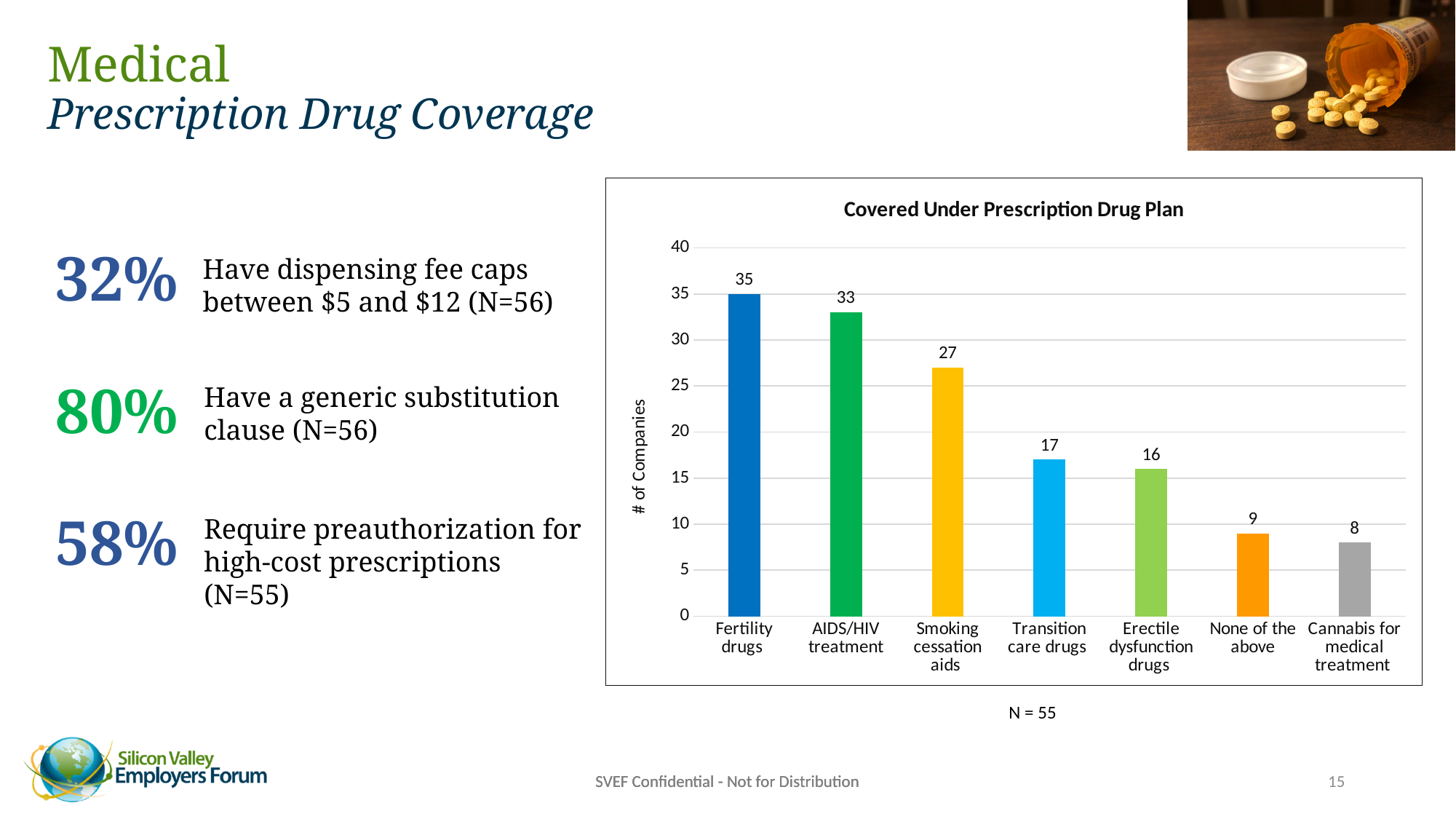
What is the difference between the number of companies covering fertility drugs and those covering AIDS/HIV treatment? 2 How many companies cover fertility drugs under their prescription drug plan? 35 Which category has the lowest number of companies? Cannabis for medical treatment Which category has the highest number of companies? Fertility drugs How many companies cover cannabis for medical treatment? 8 What is the title of the chart? Covered Under Prescription Drug Plan Which has more companies: smoking cessation aids or transition care drugs? Smoking cessation aids What type of chart is shown on the slide? Bar chart What is the difference between the number of companies covering transition care drugs and those covering erectile dysfunction drugs? 1 How many companies cover smoking cessation aids? 27 How many categories are shown on the x axis of the chart? 7 Is the value for 'None of the above' greater or less than 10? less